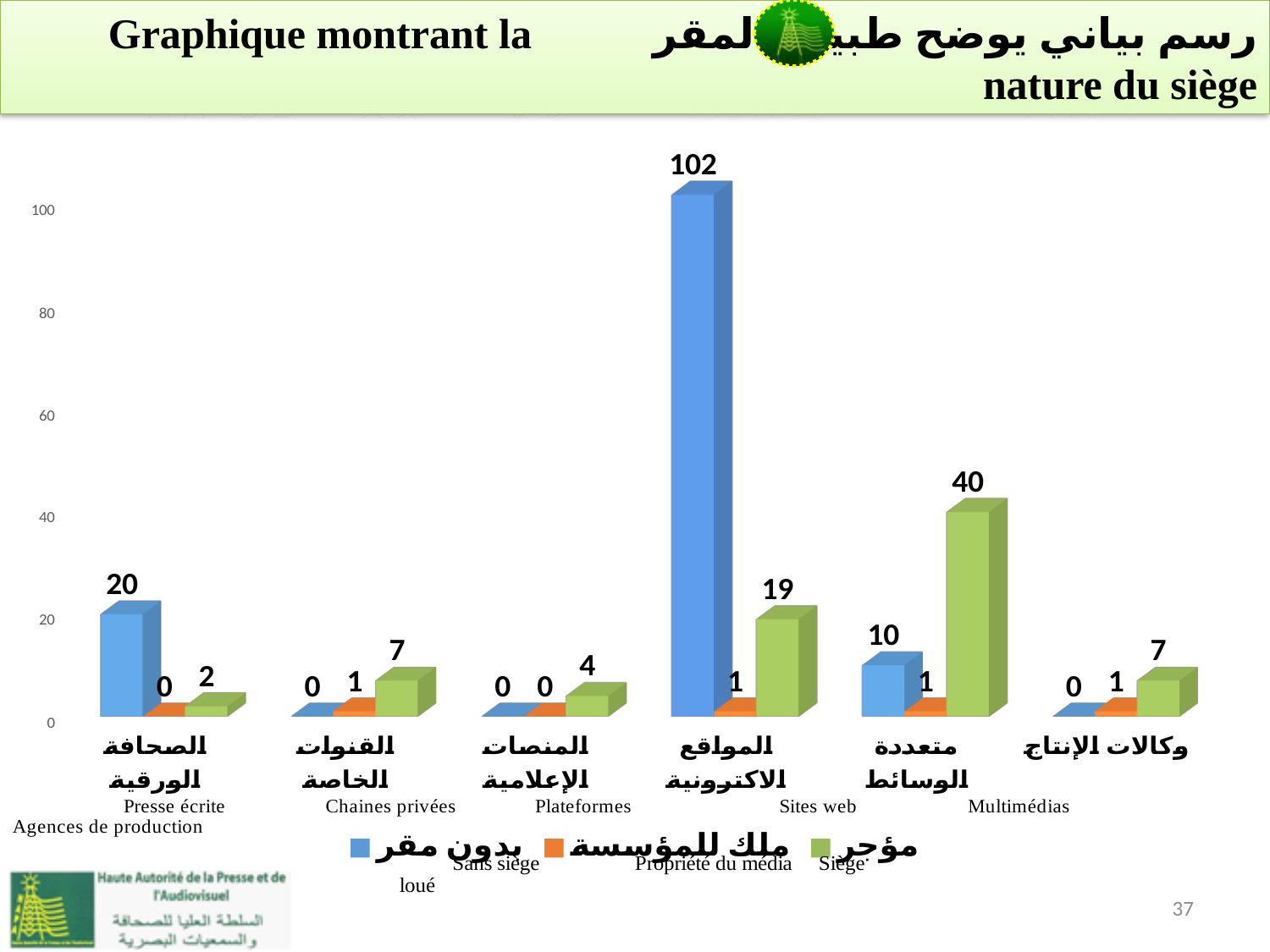
Which is larger for Multimédias: the Sans siège value or the Siège loué value? Siège loué (40) How many categories are shown on the x axis? 6 What is the value for Siège loué (مؤجر) for Plateformes (المنصات الإعلامية)? 4 Which category has the highest value for Sans siège (بدون مقر)? Sites web (المواقع الالكترونية) What is the value for Sans siège (بدون مقر) for Presse écrite (الصحافة الورقية)? 20 Which category has the highest value for Siège loué (مؤجر)? Multimédias (متعددة الوسائط) What kind of chart is shown on the slide? Bar chart What is the total of the three values for Sites web (المواقع الالكترونية)? 122 How many series does the legend list? 3 What is the value for Siège loué (مؤجر) for Multimédias (متعددة الوسائط)? 40 What is the difference between the Sans siège value for Sites web and the Sans siège value for Presse écrite? 82 What is the value for Sans siège (بدون مقر) for Sites web (المواقع الالكترونية)? 102